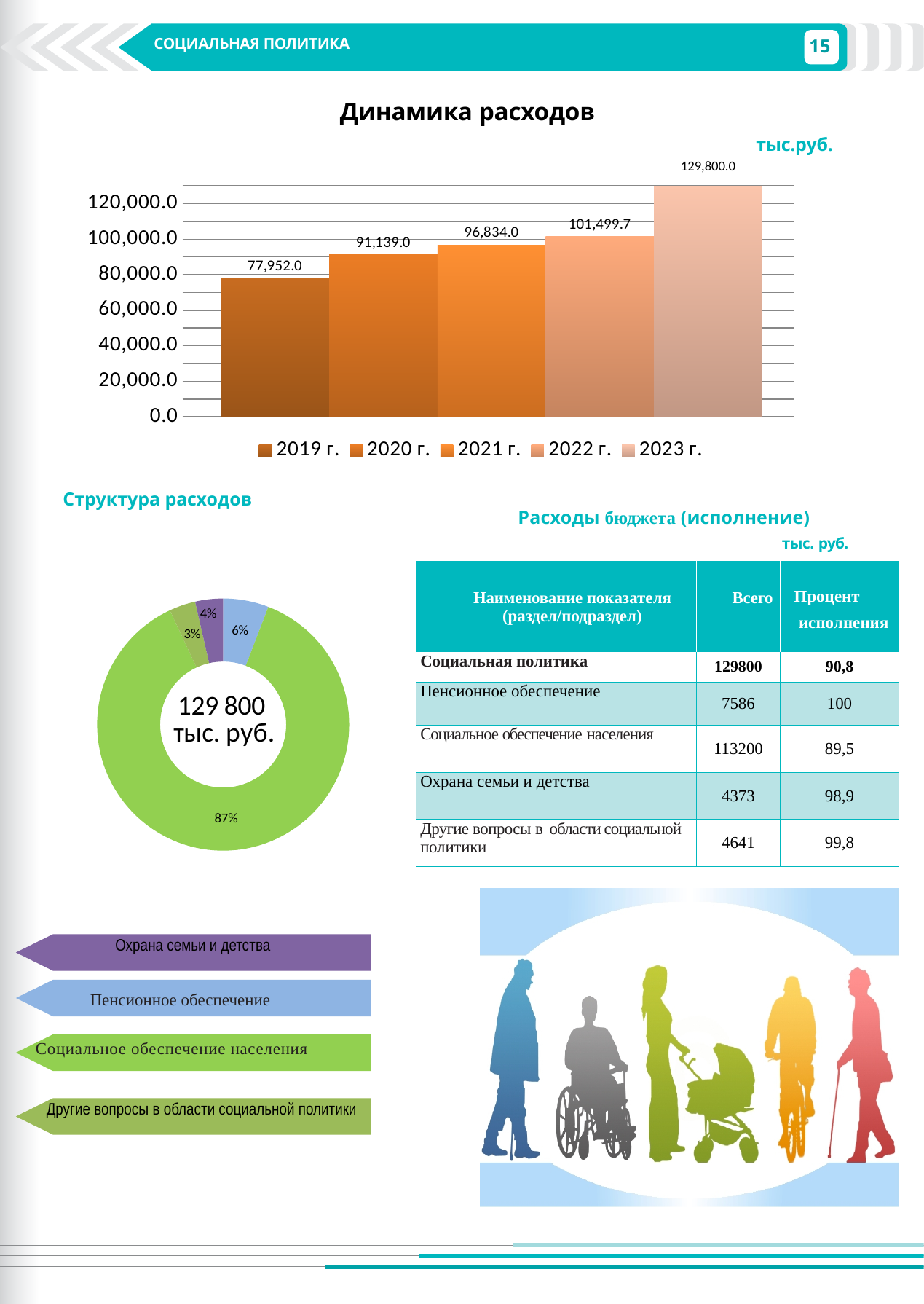
What kind of chart is 'Динамика расходов'? bar chart In the 'Динамика расходов' chart, which year has the lowest value? 2019 г. In the 'Динамика расходов' chart, which year has the highest value? 2023 г. In the 'Структура расходов' chart, what share does the blue slice (Пенсионное обеспечение) have? 6% In the 'Динамика расходов' chart, what is the difference between the values for 2023 г. and 2022 г.? 28,300.3 In the 'Динамика расходов' chart, do the values rise or fall from 2019 г. to 2023 г.? rise In the 'Динамика расходов' chart, what is the value for 2022 г.? 101,499.7 In the 'Динамика расходов' chart, how many years are plotted? 5 What total value is shown in the centre of the 'Структура расходов' chart? 129 800 тыс. руб. In the 'Структура расходов' chart, what share does the largest slice have? 87% In the 'Динамика расходов' chart, which is larger: the value for 2020 г. or 2021 г.? 2021 г. In the 'Динамика расходов' chart, what is the value for 2019 г.? 77,952.0